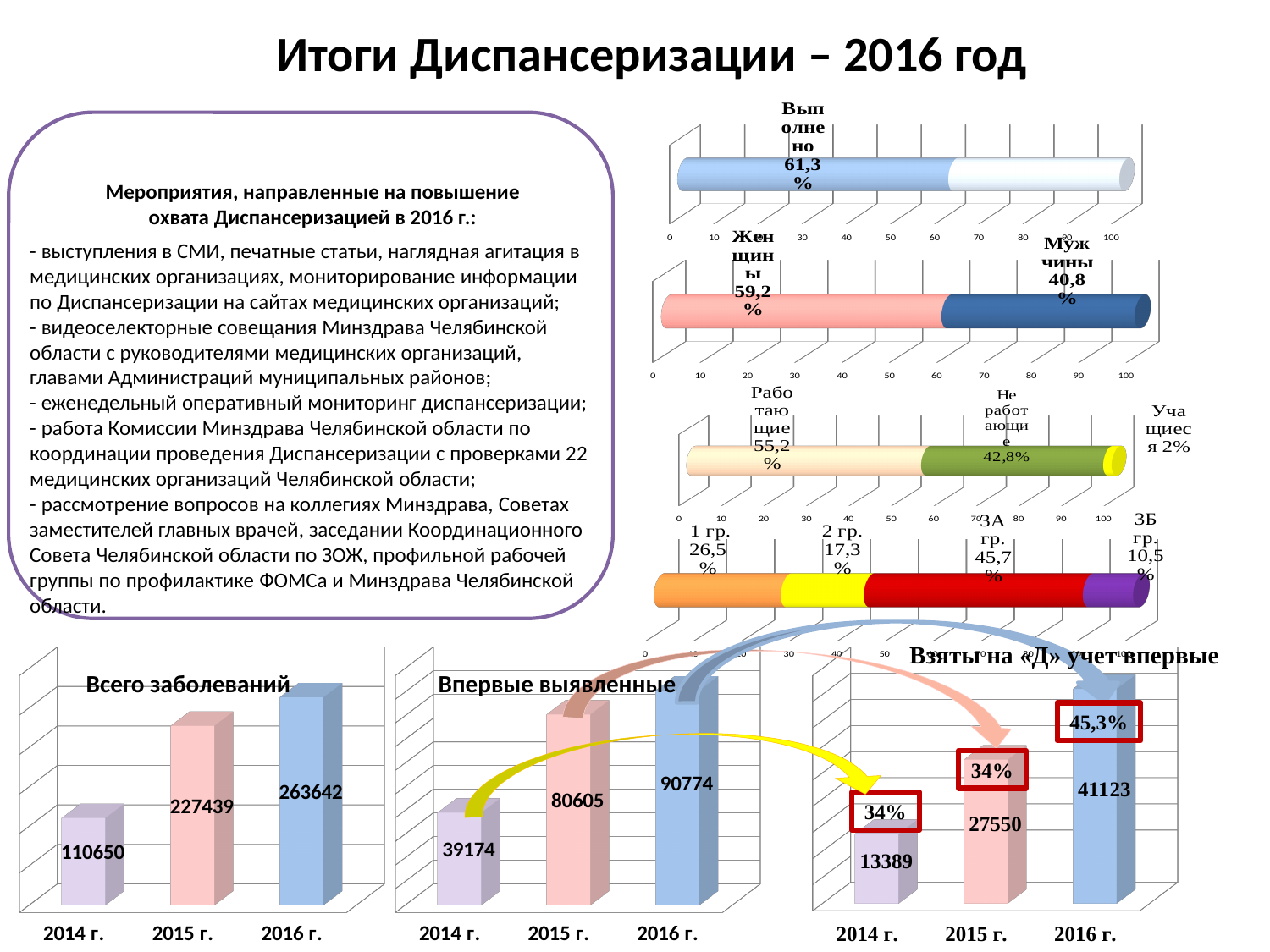
In the 'Всего заболеваний' chart, what is the value for 2016 г.? 263642 In the 'Впервые выявленные' chart, what is the value for 2015 г.? 80605 In the horizontal bar chart showing Работающие, Не работающие and Учащиеся, what is the share for Учащиеся? 2% In the 'Впервые выявленные' chart, what is the difference between the 2016 г. and 2014 г. values? 51600 In the horizontal bar chart showing Женщины and Мужчины, what is the share for Мужчины? 40,8% In the 'Взяты на «Д» учет впервые' chart, do the values rise or fall from 2014 г. to 2016 г.? rise In the 'Взяты на «Д» учет впервые' chart, what percentage is shown above the 2016 г. bar? 45,3% In the horizontal bar chart showing health groups (1 гр., 2 гр., 3А гр., 3Б гр.), which group has the largest share? 3А гр. In the 'Всего заболеваний' chart, which year has the lowest value? 2014 г. What kind of chart is the 'Впервые выявленные' chart? bar chart In the 'Всего заболеваний' chart, how many years are plotted? 3 In the 'Взяты на «Д» учет впервые' chart, what is the value for 2014 г.? 13389